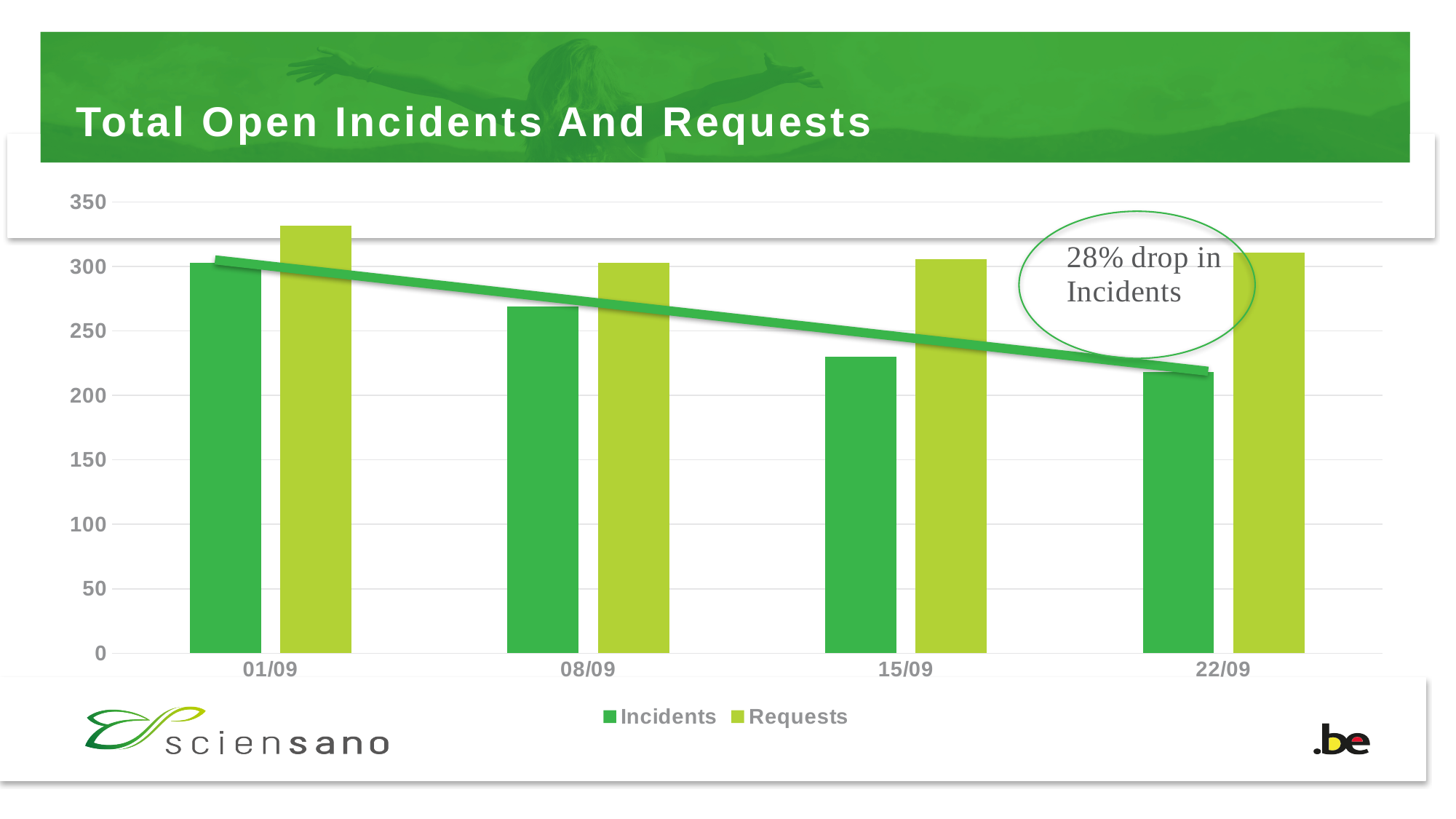
On which date is the Incidents value lowest? 22/09 Is the Incidents value for 15/09 greater or less than 250? less Is the Requests value for 01/09 greater or less than 300? greater What percentage drop in Incidents does the annotation on the chart state? 28% Do the Incidents values rise or fall from 01/09 to 22/09? fall How many series does the legend list? 2 What kind of chart is shown on the slide? bar chart On which date is the Requests value highest? 01/09 Is the Incidents value for 08/09 greater or less than 250? greater On 22/09, which is larger, Incidents or Requests? Requests How many dates are shown on the x axis of the chart? 4 On which date is the Incidents value highest? 01/09